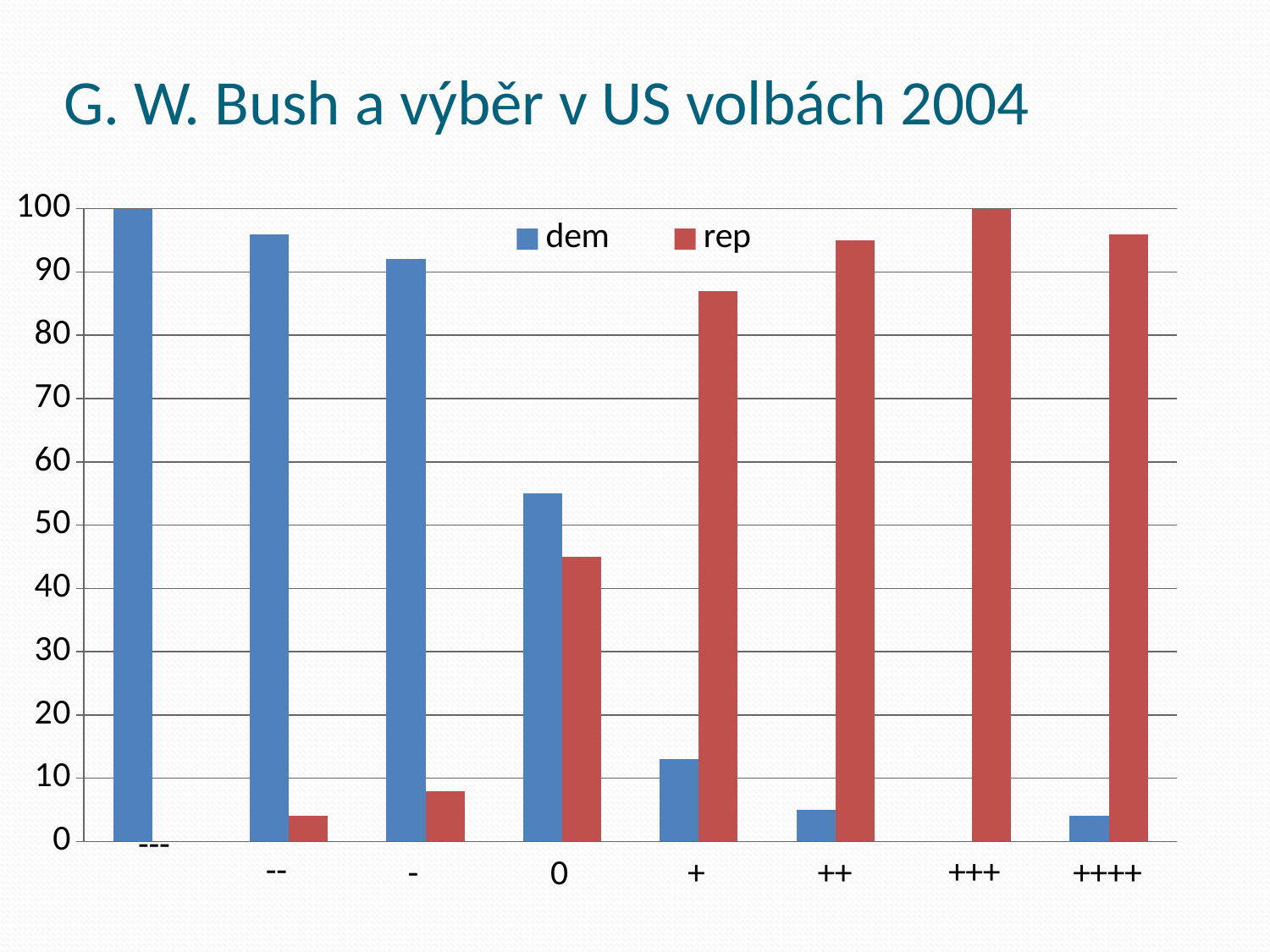
What type of chart is shown on the slide? bar chart For which category is the rep series highest? +++ What is the value of the dem series for the category "---"? 100 How many series does the legend list? 2 Is the value of the rep series for the category "+" greater or less than 80? greater How many categories are shown on the x axis? 8 For which category is the dem series highest? --- Is the value of the rep series for the category "-" greater or less than 10? less Do the values of the dem series rise or fall from left to right along the x axis? fall Is the value of the dem series for the category "0" greater or less than 50? greater What is the value of the rep series for the category "+++"? 100 For the category "+", which series has the larger value, dem or rep? rep